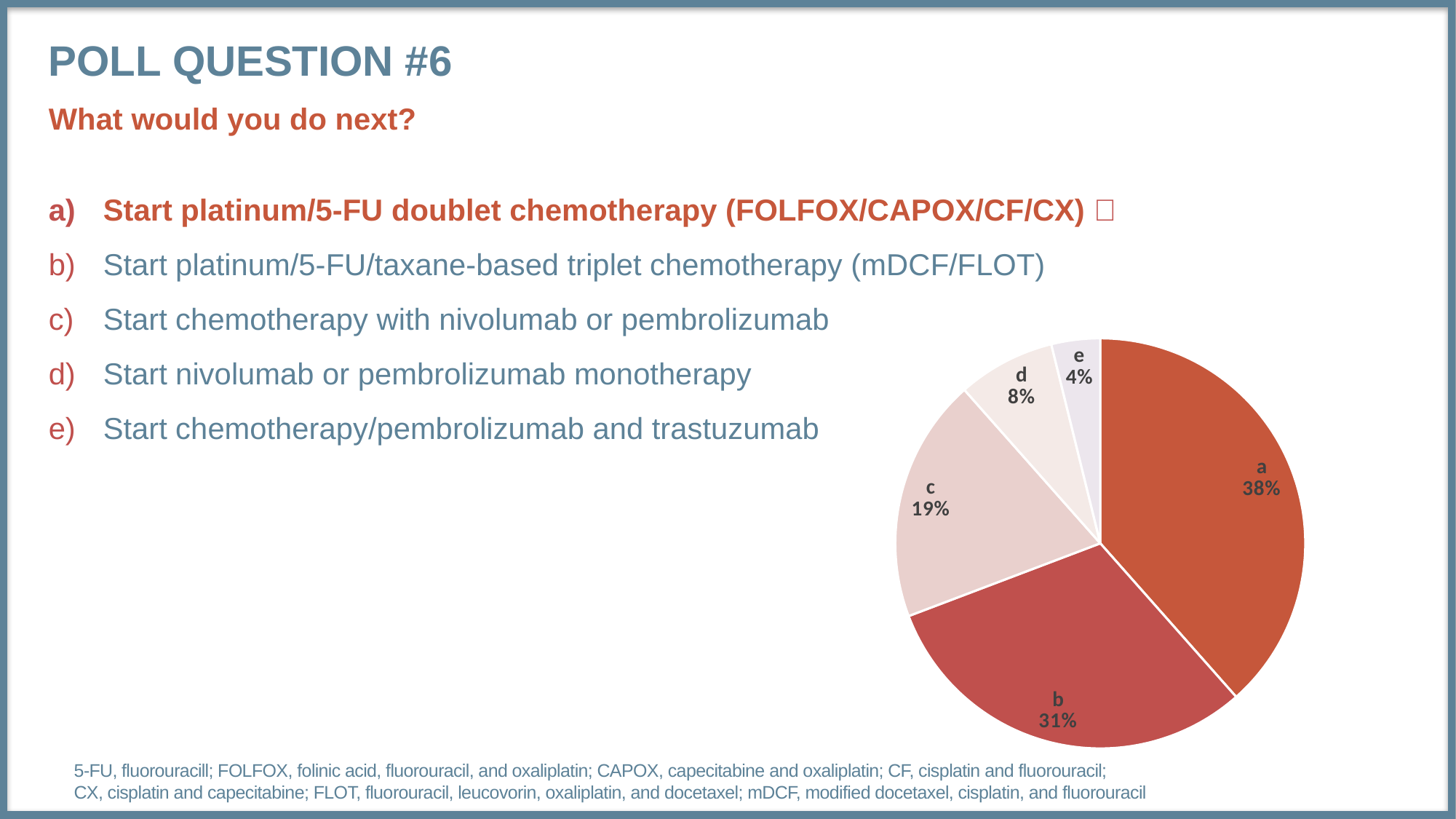
What is the combined share of options d and e? 12% What kind of chart is shown on the slide? pie chart What percentage of respondents chose option a? 38% What is the difference in percentage points between option a and option b? 7 Which option received the smallest share of responses? e What percentage of respondents chose option d? 8% What percentage of respondents chose option e? 4% What percentage of respondents chose option b? 31% Which option received the largest share of responses? a What percentage of respondents chose option c? 19% Which received a larger share of responses, option c or option d? c How many slices does the pie chart have? 5